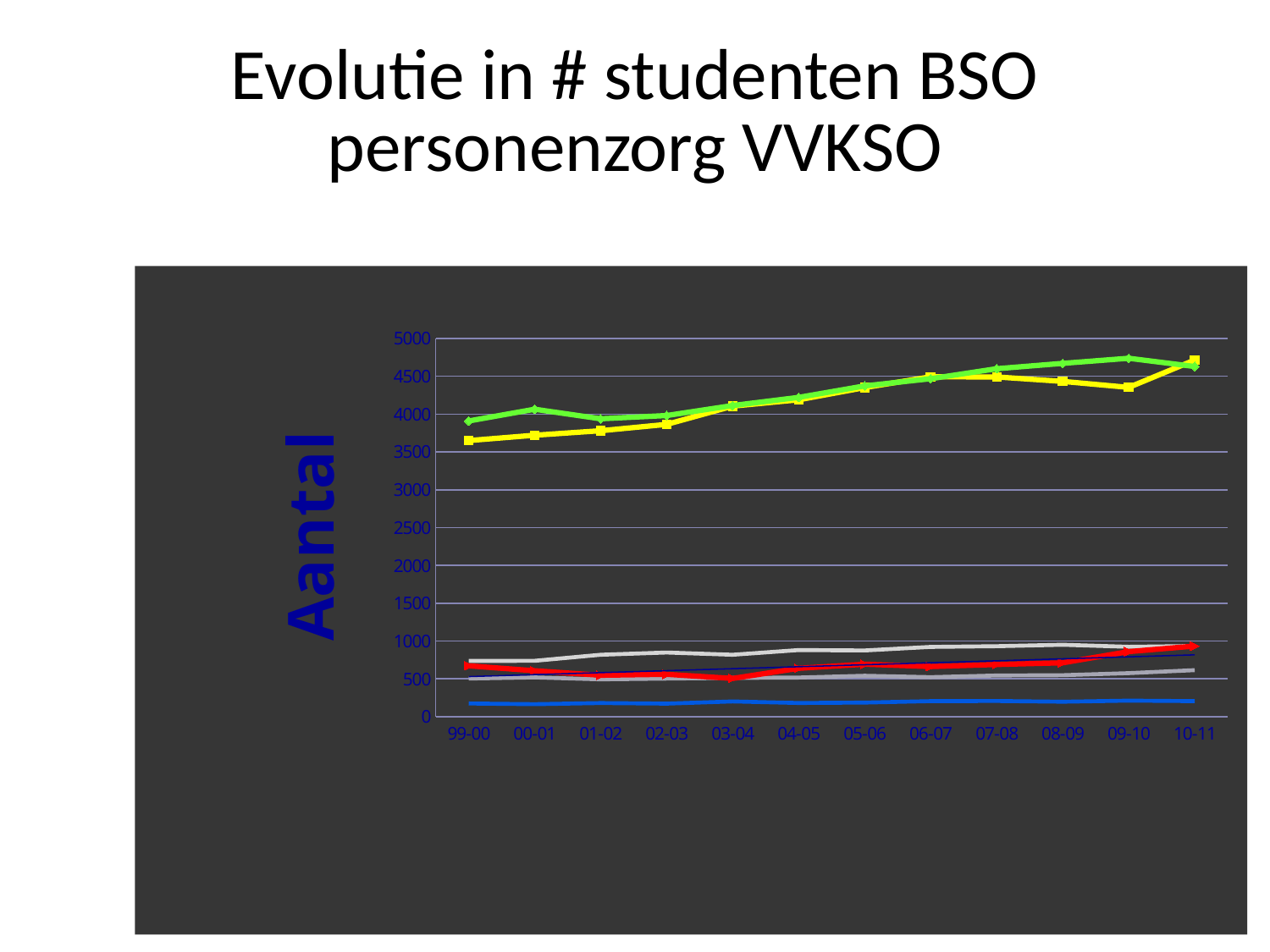
Does the green line generally rise or fall from 99-00 to 10-11? rise How many school-year categories are shown on the x axis? 12 At 99-00, which is higher: the green line or the yellow line? the green line Is the value of the green line at 09-10 greater or less than 4500? greater Is the value of the yellow line at 99-00 greater or less than 4000? less Is the value of the blue line at 05-06 greater or less than 500? less What is the title of the vertical axis? Aantal What kind of chart is shown on the slide? line chart What is the first category on the x axis? 99-00 Does the yellow line generally rise or fall from 99-00 to 06-07? rise